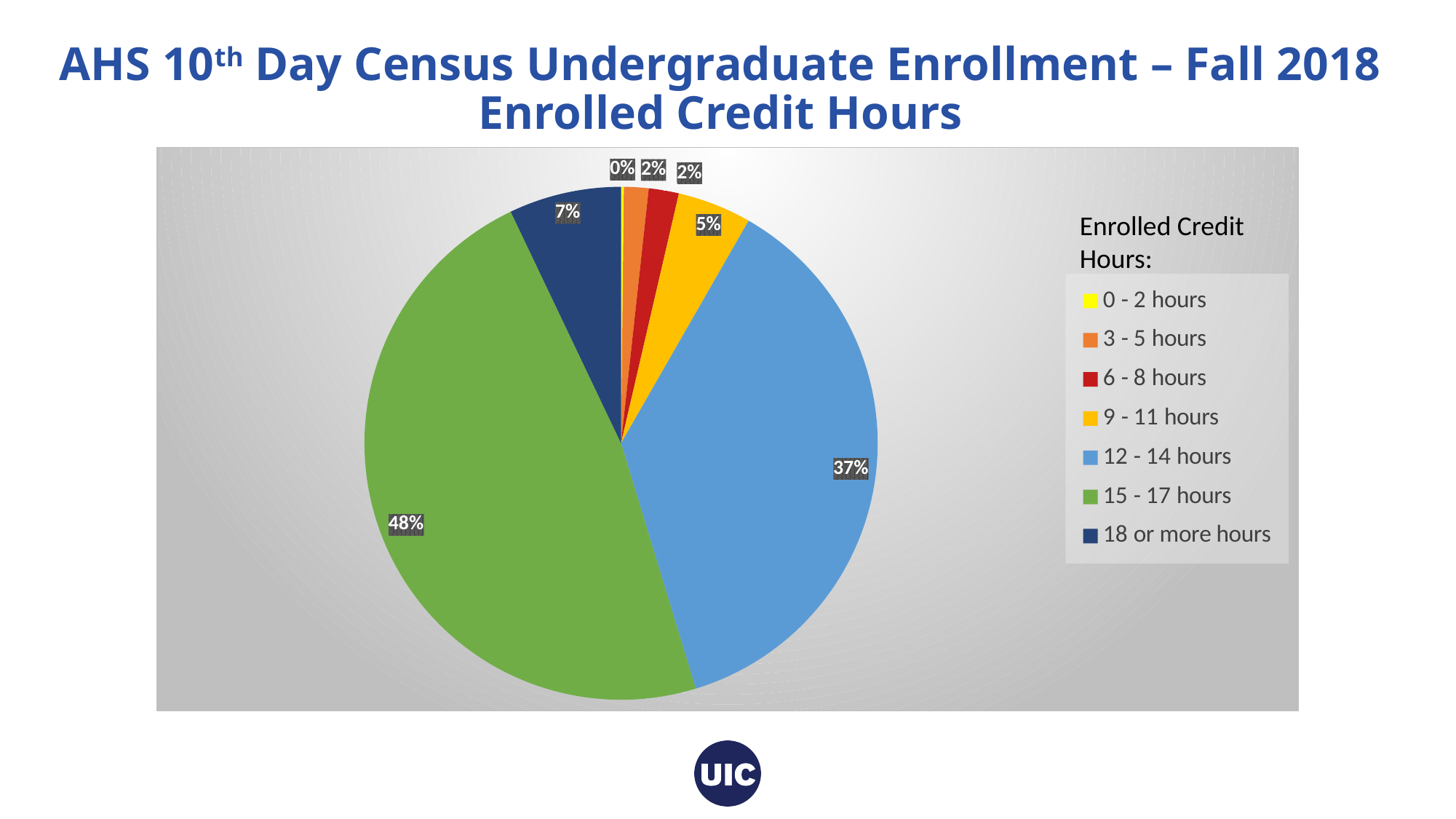
What share of the pie is the 12 - 14 hours slice? 37% How many credit-hour categories does the legend list? 7 What share of the pie is the 15 - 17 hours slice? 48% Which credit-hour category has the largest share of the pie? 15 - 17 hours What percentage is shown for 0 - 2 hours? 0% What percentage is shown for 9 - 11 hours? 5% What is the difference in percentage points between the 15 - 17 hours slice and the 12 - 14 hours slice? 11 What percentage is shown for 18 or more hours? 7% Which is larger, the share for 18 or more hours or the share for 9 - 11 hours? 18 or more hours Which credit-hour category has the smallest share of the pie? 0 - 2 hours What kind of chart is shown on the slide? pie chart What colour represents the 12 - 14 hours category in the legend? light blue